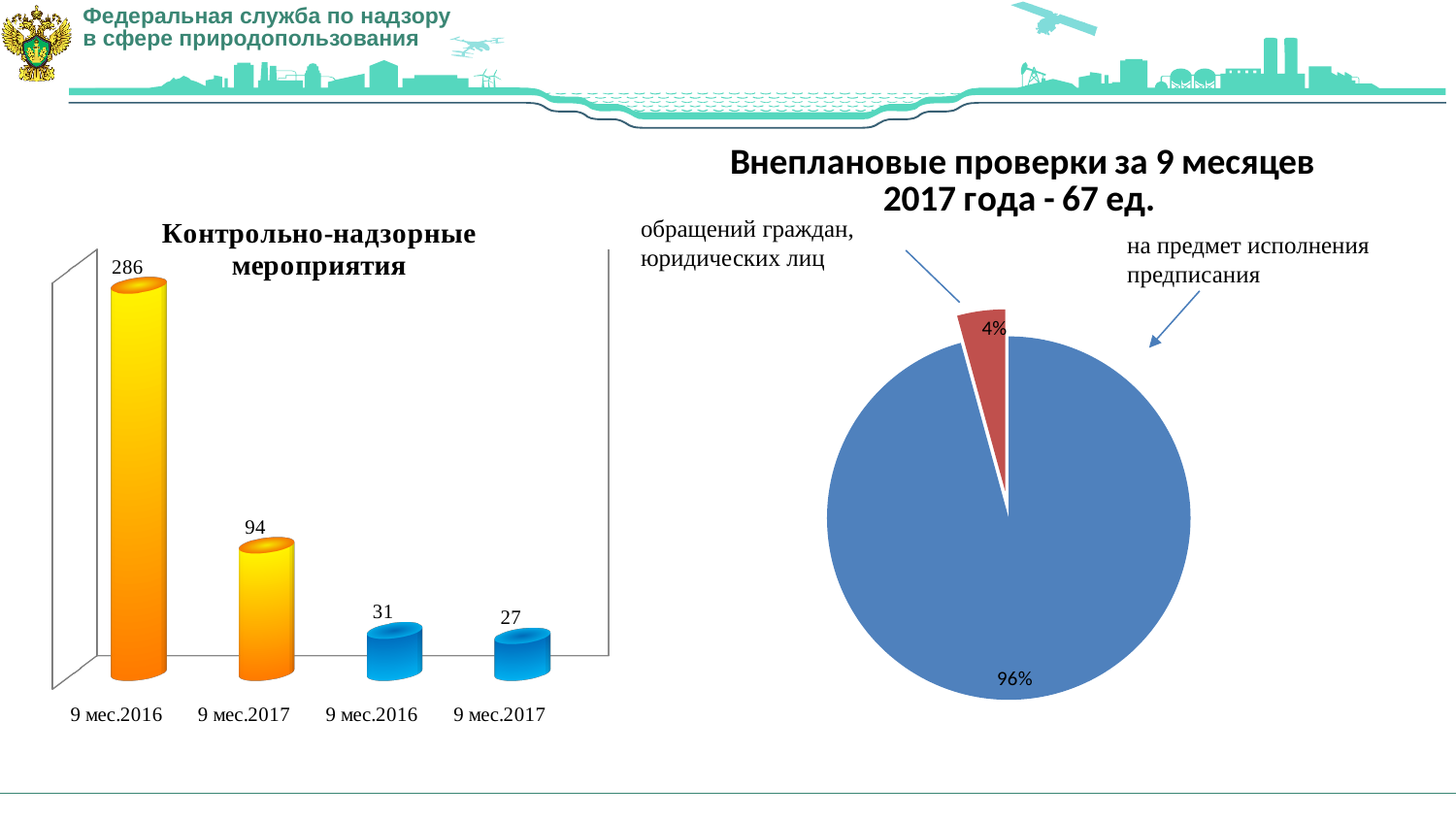
In the chart titled 'Контрольно-надзорные мероприятия', what is the difference between the two orange bars (286 and 94)? 192 In the chart titled 'Контрольно-надзорные мероприятия', what is the value of the rightmost bar, labelled 9 мес.2017? 27 In the pie chart on the right, which slice is larger: 'на предмет исполнения предписания' or 'обращений граждан, юридических лиц'? на предмет исполнения предписания What kind of chart is the one titled 'Контрольно-надзорные мероприятия'? Bar chart In the chart titled 'Контрольно-надзорные мероприятия', what is the value of the first (leftmost) bar, labelled 9 мес.2016? 286 In the chart titled 'Контрольно-надзорные мероприятия', how many bars are plotted? 4 In the chart titled 'Контрольно-надзорные мероприятия', what is the difference between the two blue bars (31 and 27)? 4 In the chart titled 'Контрольно-надзорные мероприятия', which bar has the lowest value? The rightmost bar, 9 мес.2017 (27) In the chart titled 'Контрольно-надзорные мероприятия', which bar has the highest value? The first bar, 9 мес.2016 (286) In the chart titled 'Контрольно-надзорные мероприятия', what is the value of the second orange bar, labelled 9 мес.2017? 94 In the pie chart titled 'Внеплановые проверки за 9 месяцев 2017 года - 67 ед.', what share is labelled 'на предмет исполнения предписания'? 96% In the pie chart titled 'Внеплановые проверки за 9 месяцев 2017 года - 67 ед.', what share is labelled 'обращений граждан, юридических лиц'? 4%